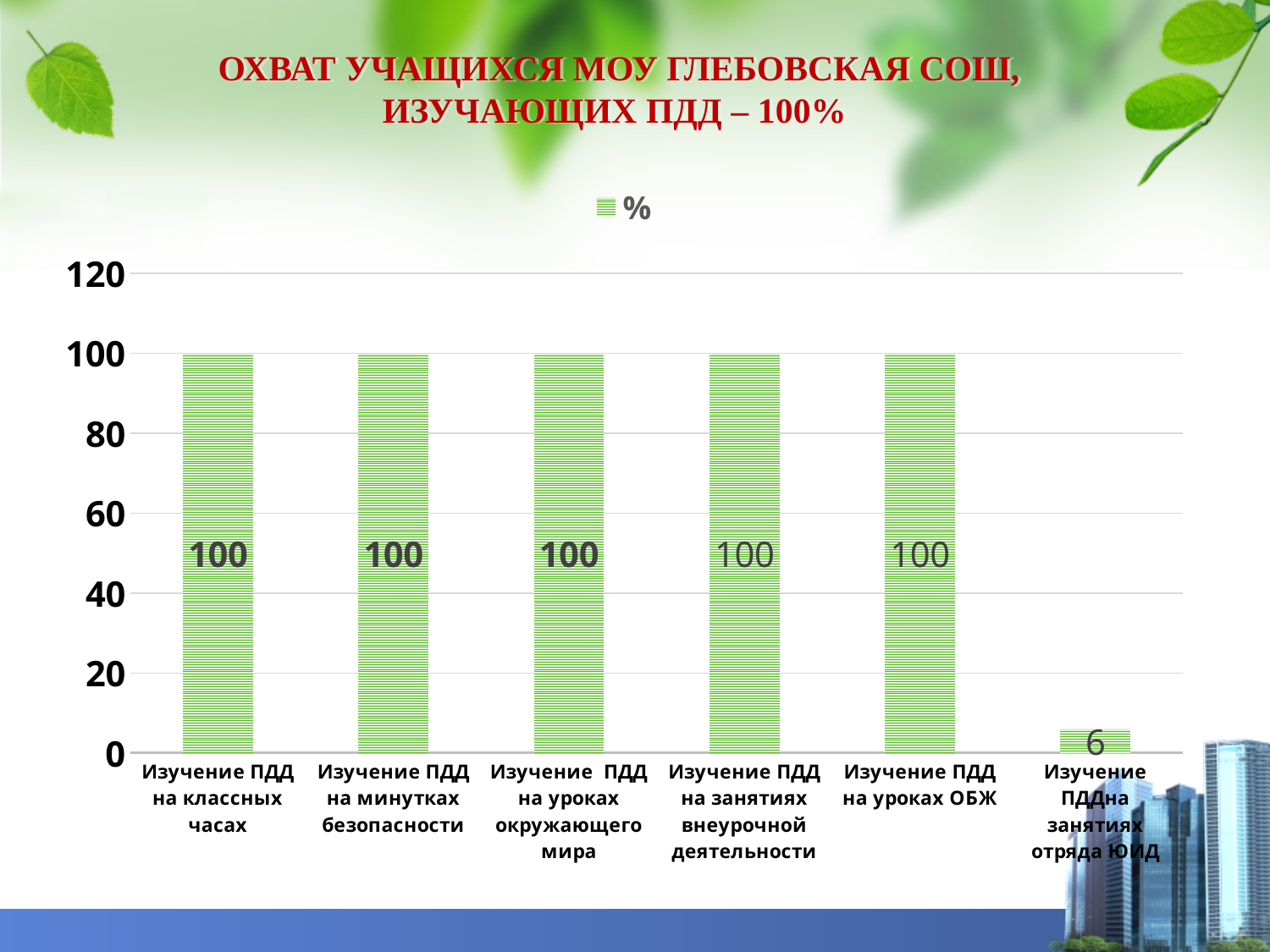
Which category has the lowest value? Изучение ПДДна занятиях отряда ЮИД Which is larger: the value for "Изучение ПДД на минутках безопасности" or the value for "Изучение ПДДна занятиях отряда ЮИД"? Изучение ПДД на минутках безопасности Is the value for "Изучение ПДДна занятиях отряда ЮИД" greater or less than 20? less What is the value for "Изучение ПДДна занятиях отряда ЮИД"? 6 What is the value for "Изучение ПДД на классных часах"? 100 How many series does the legend list? 1 What is the legend entry for the series? % What is the difference between the value for "Изучение ПДД на уроках ОБЖ" and the value for "Изучение ПДДна занятиях отряда ЮИД"? 94 How many categories are shown on the x axis? 6 What kind of chart is shown on the slide? bar chart What is the value for "Изучение ПДД на уроках ОБЖ"? 100 How many categories have a value of 100? 5